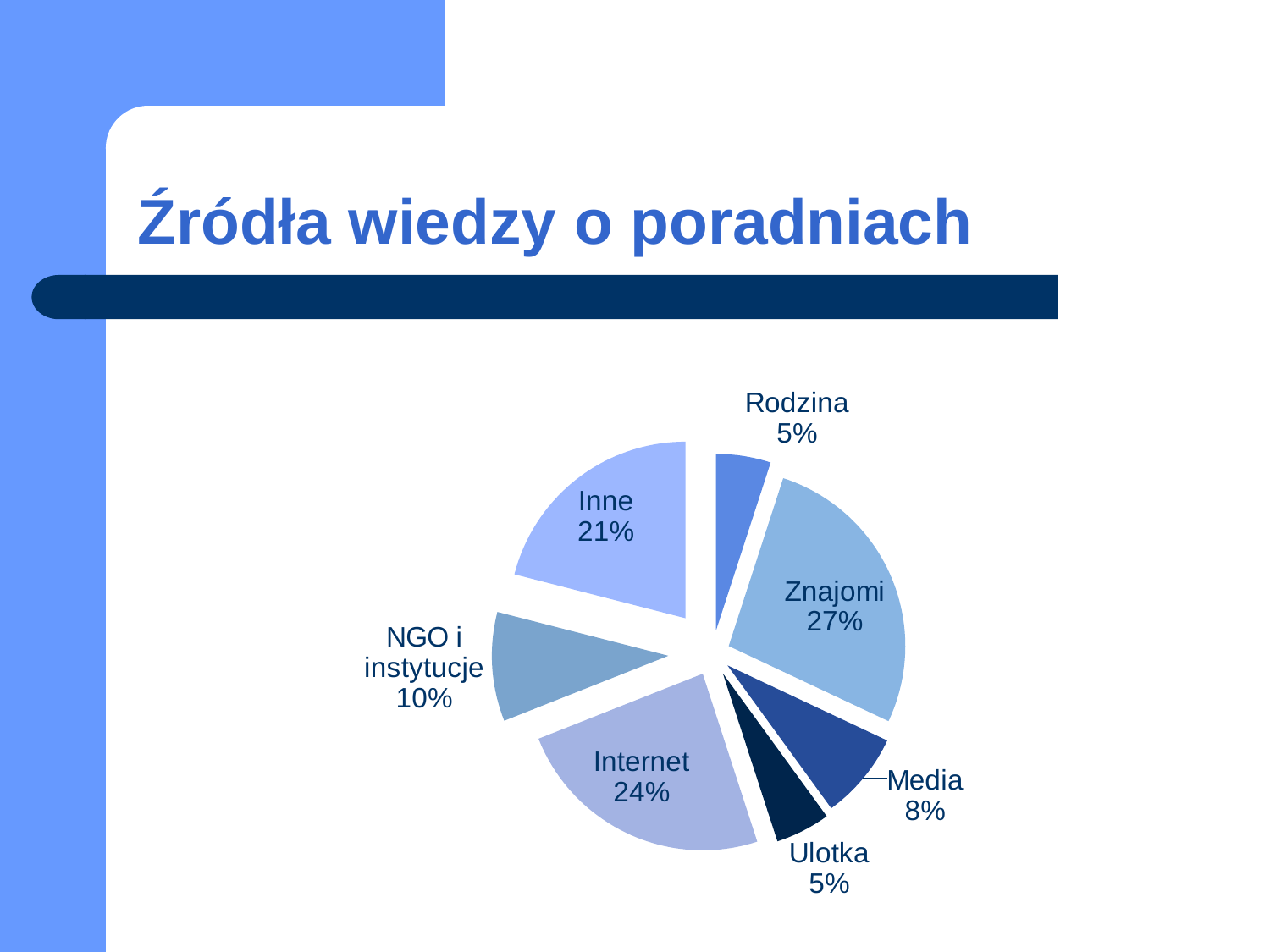
What kind of chart is shown on the slide? pie chart What share of the pie does Internet have? 24% Which category has the largest slice of the pie? Znajomi What is the title of the chart on the slide? Źródła wiedzy o poradniach What share of the pie does Znajomi have? 27% What is the difference in percentage points between Inne and Media? 13 Which two categories share the same value of 5%? Rodzina and Ulotka What share of the pie does Media have? 8% How many slices does the pie chart have? 7 Which is larger, Inne or NGO i instytucje? Inne What share of the pie does NGO i instytucje have? 10% What is the difference in percentage points between Znajomi and Internet? 3